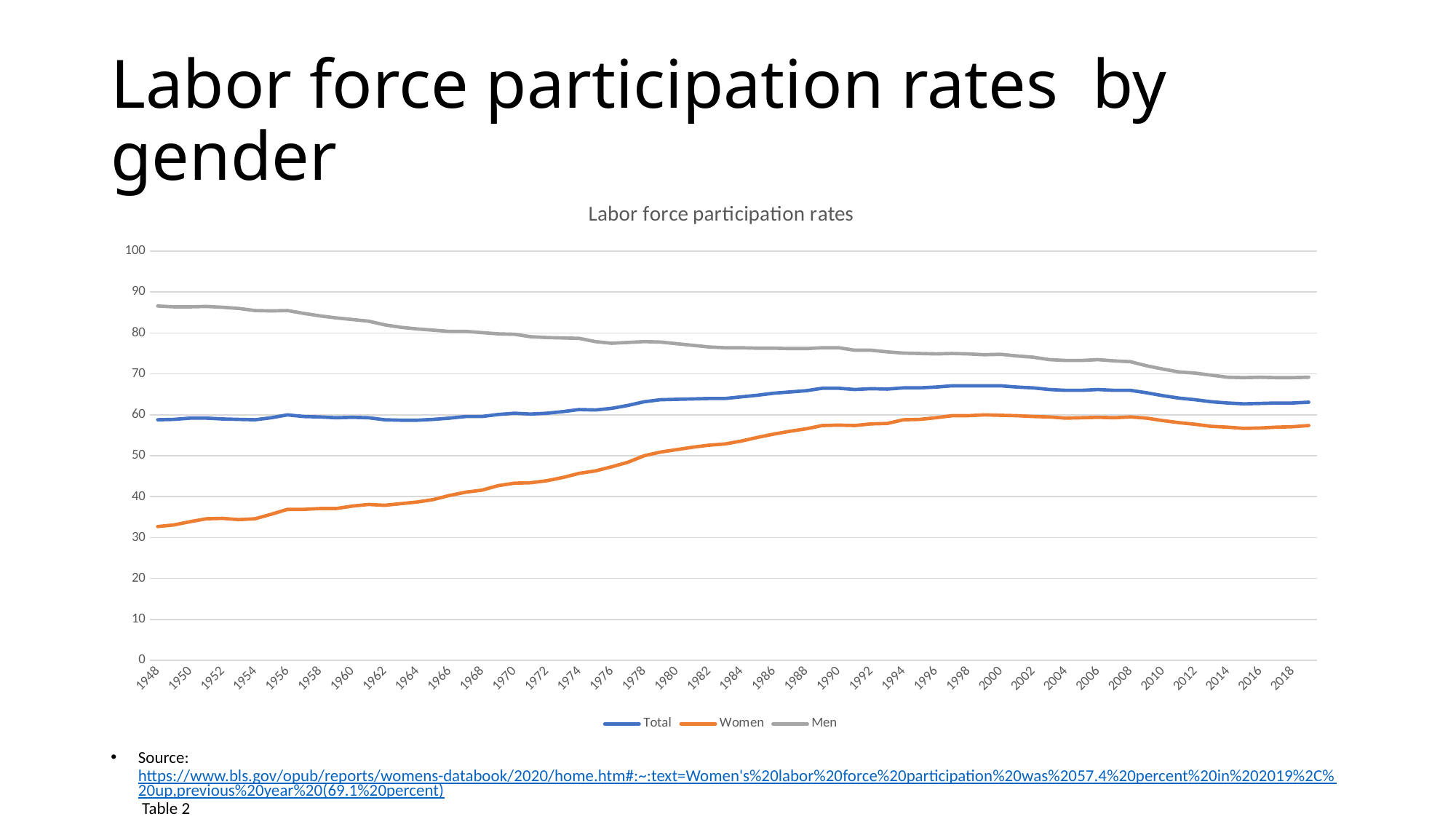
What is the title of the chart? Labor force participation rates Which series has the highest value in 2018? Men In 1948, which is larger, the value for Men or the value for Women? Men Which series has the lowest value in 1948? Women What kind of chart is shown on the slide? Line chart Is the value for Women in 1948 greater or less than 40? less Which series is plotted with the orange line? Women Does the Women series rise or fall from 1948 to 2018? Rise How many series does the legend list? 3 Is the value for Men in 1948 greater or less than 80? greater Is the value for Women in 1990 greater or less than 50? greater Does the Men series rise or fall from 1948 to 2018? Fall